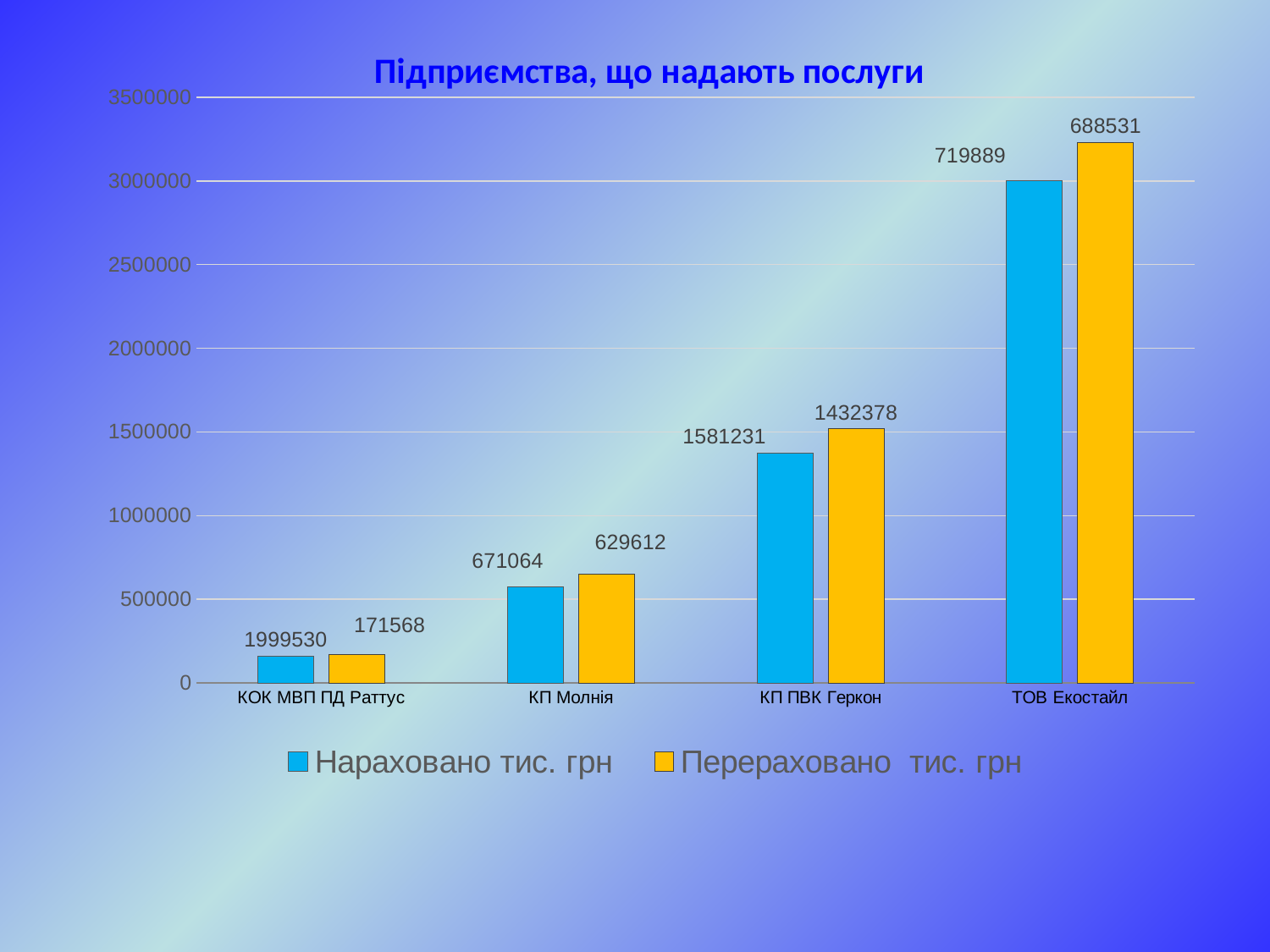
What is the Перераховано тис. грн value for ТОВ Екостайл? 688531 What is the Нараховано тис. грн value for ТОВ Екостайл? 719889 What is the Нараховано тис. грн value for КОК МВП ПД Раттус? 1999530 What is the Перераховано тис. грн value for КОК МВП ПД Раттус? 171568 What is the Нараховано тис. грн value for КП Молнія? 671064 What kind of chart is shown on the slide? Bar chart How many enterprises (categories) are shown on the x axis? 4 What is the Нараховано тис. грн value for КП ПВК Геркон? 1581231 What is the Перераховано тис. грн value for КП Молнія? 629612 How many series does the legend list? 2 What is the Перераховано тис. грн value for КП ПВК Геркон? 1432378 What is the title of the chart? Підприємства, що надають послуги